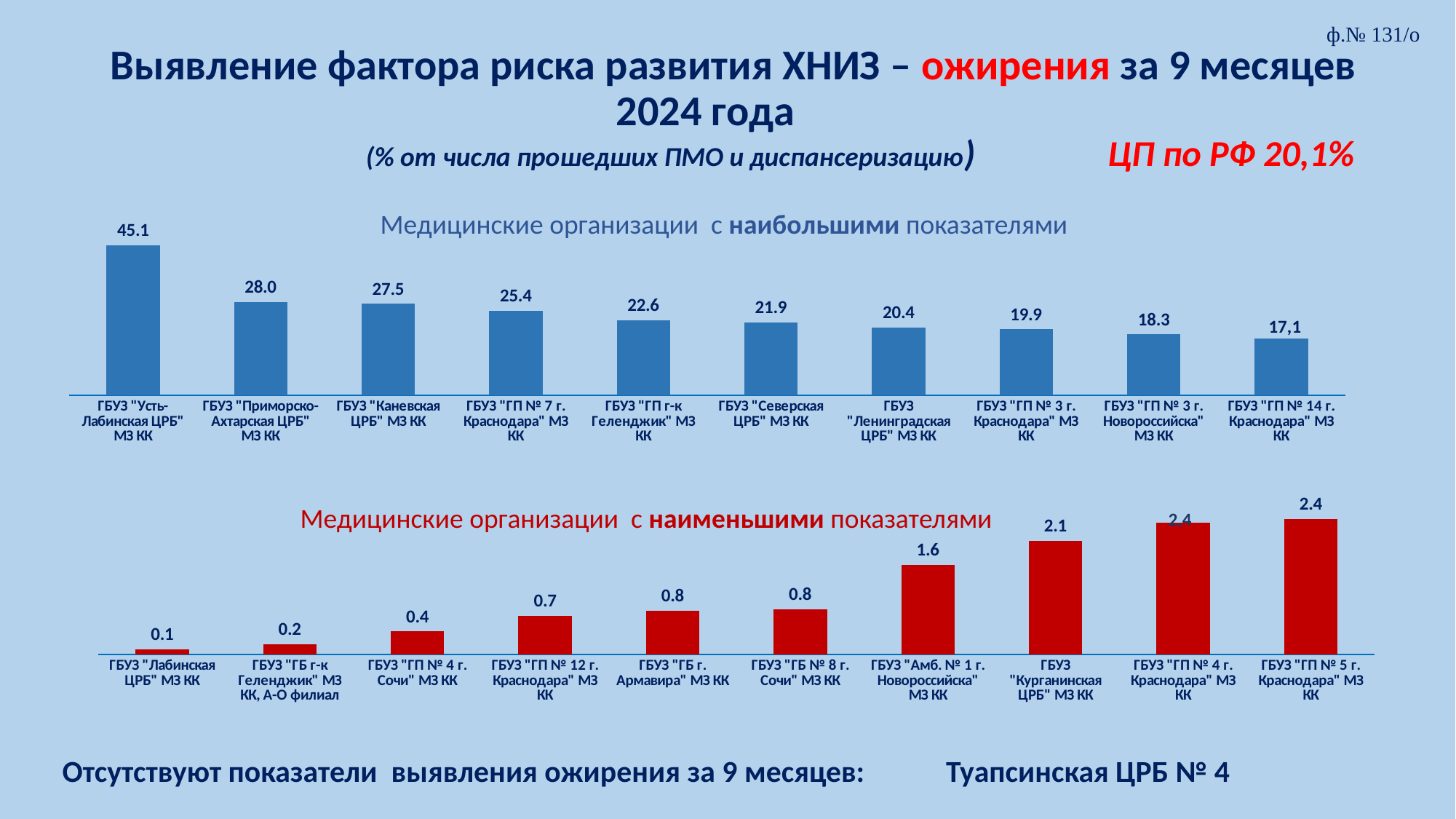
На нижней диаграмме на сколько значение ГБУЗ "ГП № 5 г. Краснодара" МЗ КК больше значения ГБУЗ "ГП № 12 г. Краснодара" МЗ КК? 1.7 На нижней диаграмме «Медицинские организации с наименьшими показателями» какое значение у ГБУЗ "Амб. № 1 г. Новороссийска" МЗ КК? 1.6 Какого типа нижняя диаграмма? столбчатая (bar chart) Какого цвета столбцы на нижней диаграмме? красного На верхней диаграмме значения растут или убывают слева направо? убывают На верхней диаграмме какое значение у ГБУЗ "Северская ЦРБ" МЗ КК? 21.9 На нижней диаграмме какая организация имеет наименьшее значение? ГБУЗ "Лабинская ЦРБ" МЗ КК На верхней диаграмме какая организация имеет наименьшее значение? ГБУЗ "ГП № 14 г. Краснодара" МЗ КК На верхней диаграмме на сколько значение ГБУЗ "Усть-Лабинская ЦРБ" МЗ КК больше значения ГБУЗ "Приморско-Ахтарская ЦРБ" МЗ КК? 17.1 На нижней диаграмме что больше: значение ГБУЗ "Курганинская ЦРБ" МЗ КК или ГБУЗ "ГБ г. Армавира" МЗ КК? ГБУЗ "Курганинская ЦРБ" МЗ КК На верхней диаграмме «Медицинские организации с наибольшими показателями» какое значение у ГБУЗ "Усть-Лабинская ЦРБ" МЗ КК? 45.1 На верхней диаграмме сколько организаций показано? 10